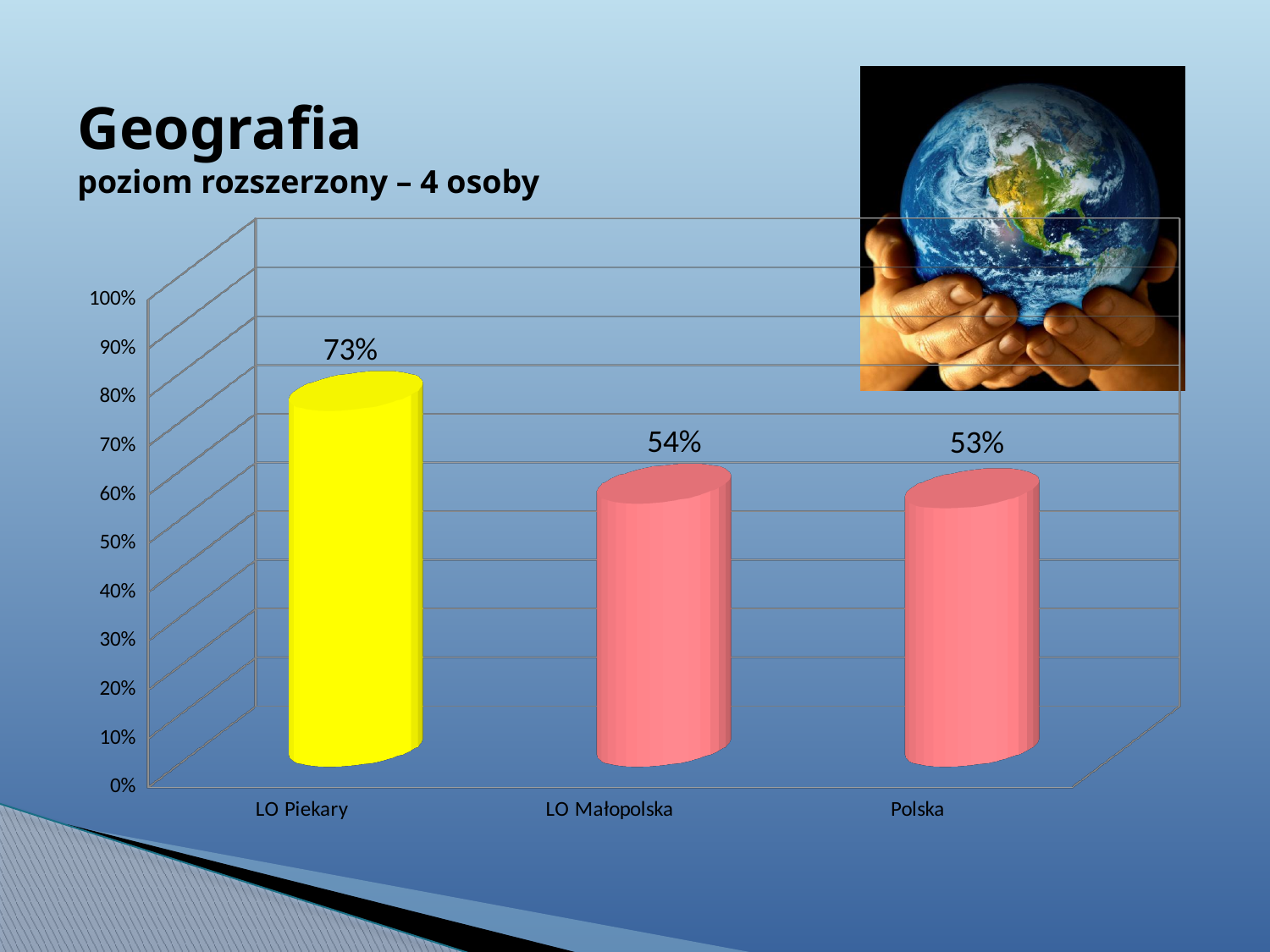
What colour is the bar for LO Piekary? yellow What is the value for LO Piekary? 73% Is the value for LO Małopolska greater or less than 50%? greater What is the difference between the values for LO Piekary and Polska? 20% Which is larger, the value for LO Piekary or the value for Polska? LO Piekary Which category has the highest value? LO Piekary What is the value for LO Małopolska? 54% How many categories are shown on the x axis? 3 Which category has the lowest value? Polska What is the difference between the values for LO Piekary and LO Małopolska? 19% What kind of chart is shown on the slide? bar chart What is the value for Polska? 53%